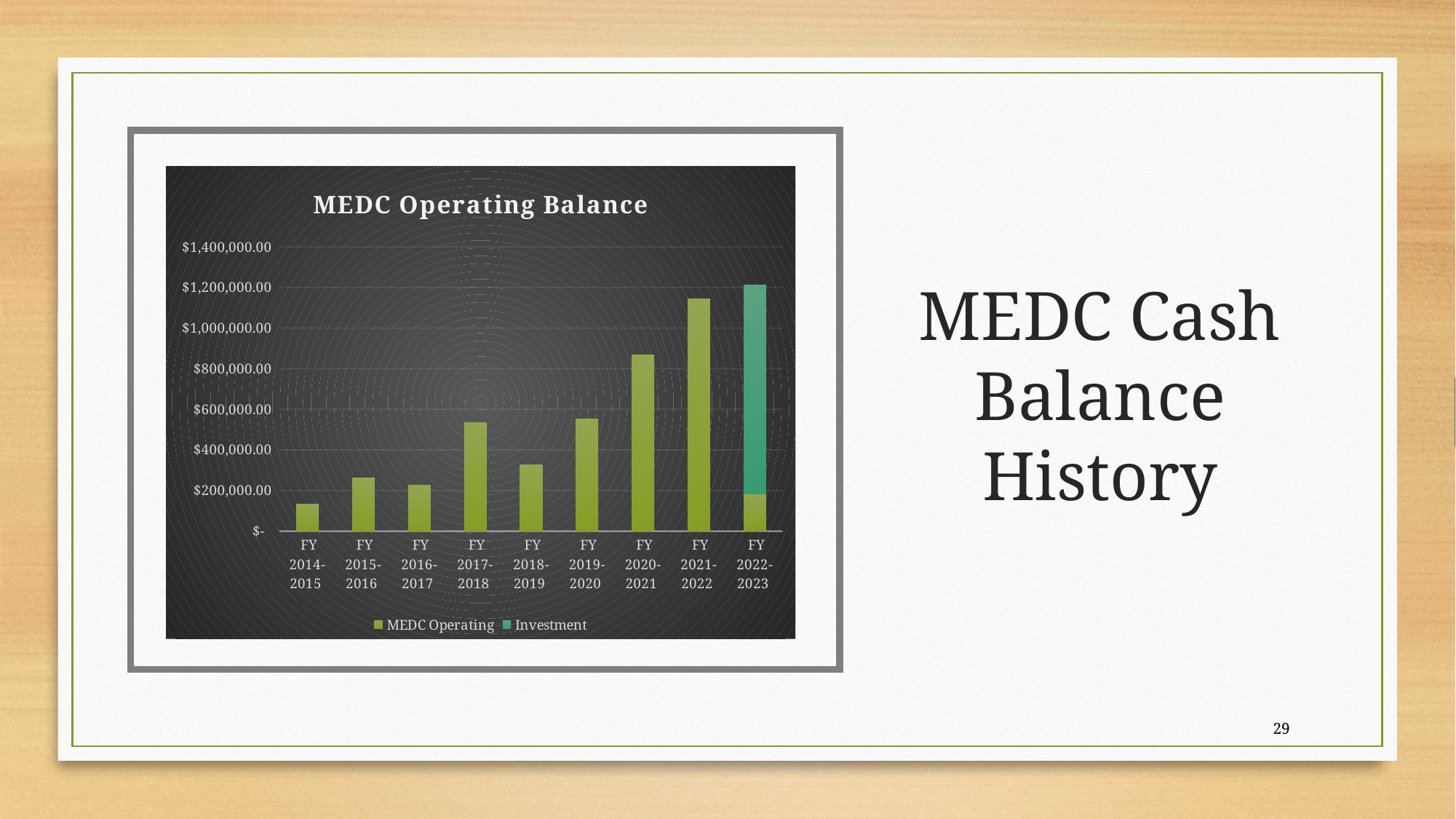
Which fiscal year has the lowest bar in the chart? FY 2014-2015 Which fiscal year is the only one with an Investment segment in its bar? FY 2022-2023 How many series does the chart's legend list? 2 What is the title of the chart? MEDC Operating Balance Which is larger, the MEDC Operating value for FY 2017-2018 or for FY 2018-2019? FY 2017-2018 Is the MEDC Operating value for FY 2014-2015 greater or less than $200,000.00? less What are the two series named in the chart's legend? MEDC Operating and Investment Is the MEDC Operating value for FY 2020-2021 greater or less than $800,000.00? greater Which fiscal year has the highest MEDC Operating value? FY 2021-2022 What kind of chart is shown on the slide? Bar chart How many fiscal years are shown on the x axis of the chart? 9 Is the MEDC Operating value for FY 2021-2022 greater or less than $1,000,000.00? greater